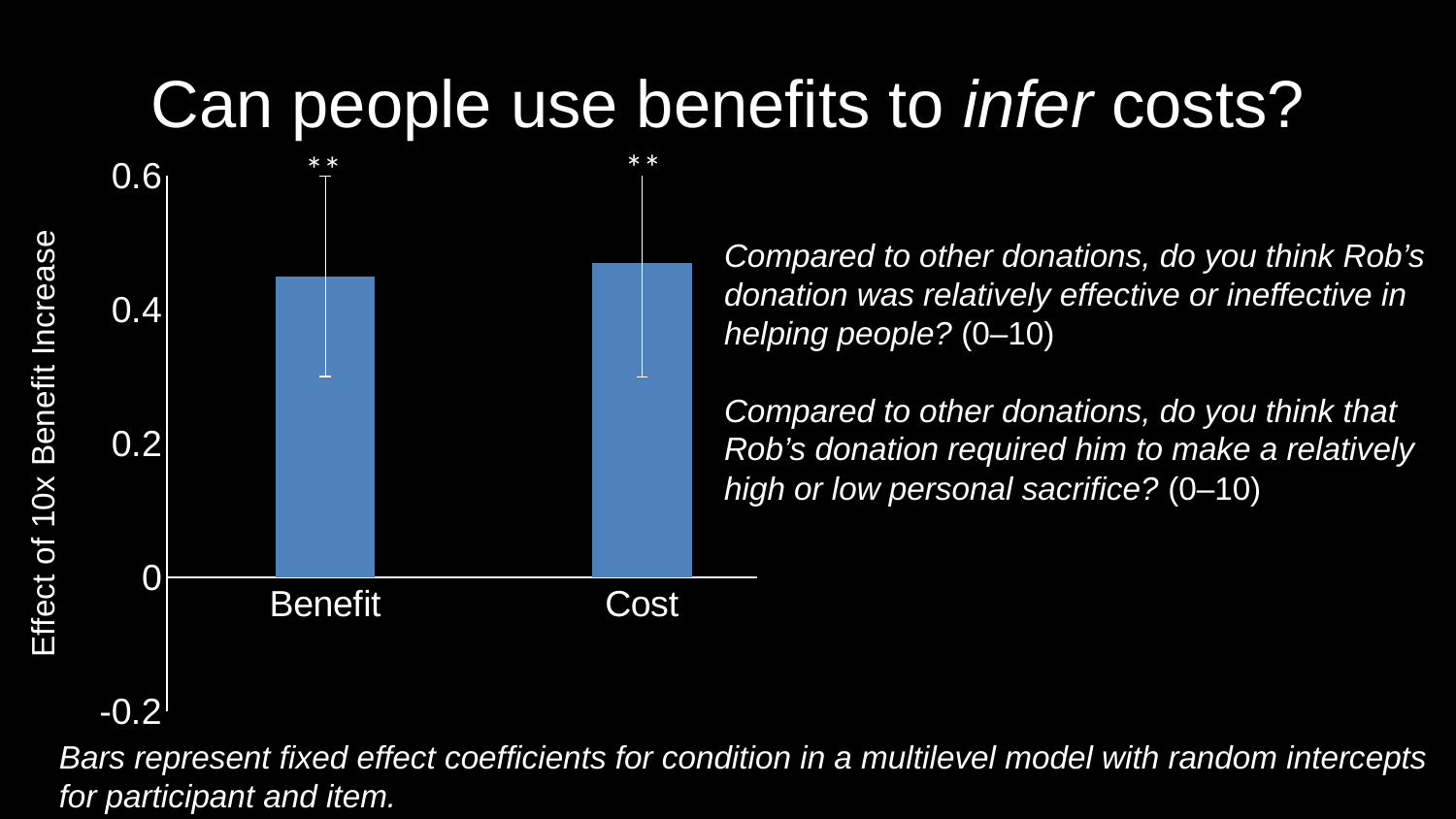
Is the value for Cost greater or less than 0.2? greater How many bars are plotted in the chart? 2 What are the two categories shown on the x axis of the chart? Benefit and Cost Is the value for Benefit greater or less than 0.4? greater Is the value for Benefit greater or less than 0.6? less What is the lowest tick value shown on the y axis? -0.2 What kind of chart is shown on the slide? bar chart What is the label on the y axis of the chart? Effect of 10x Benefit Increase